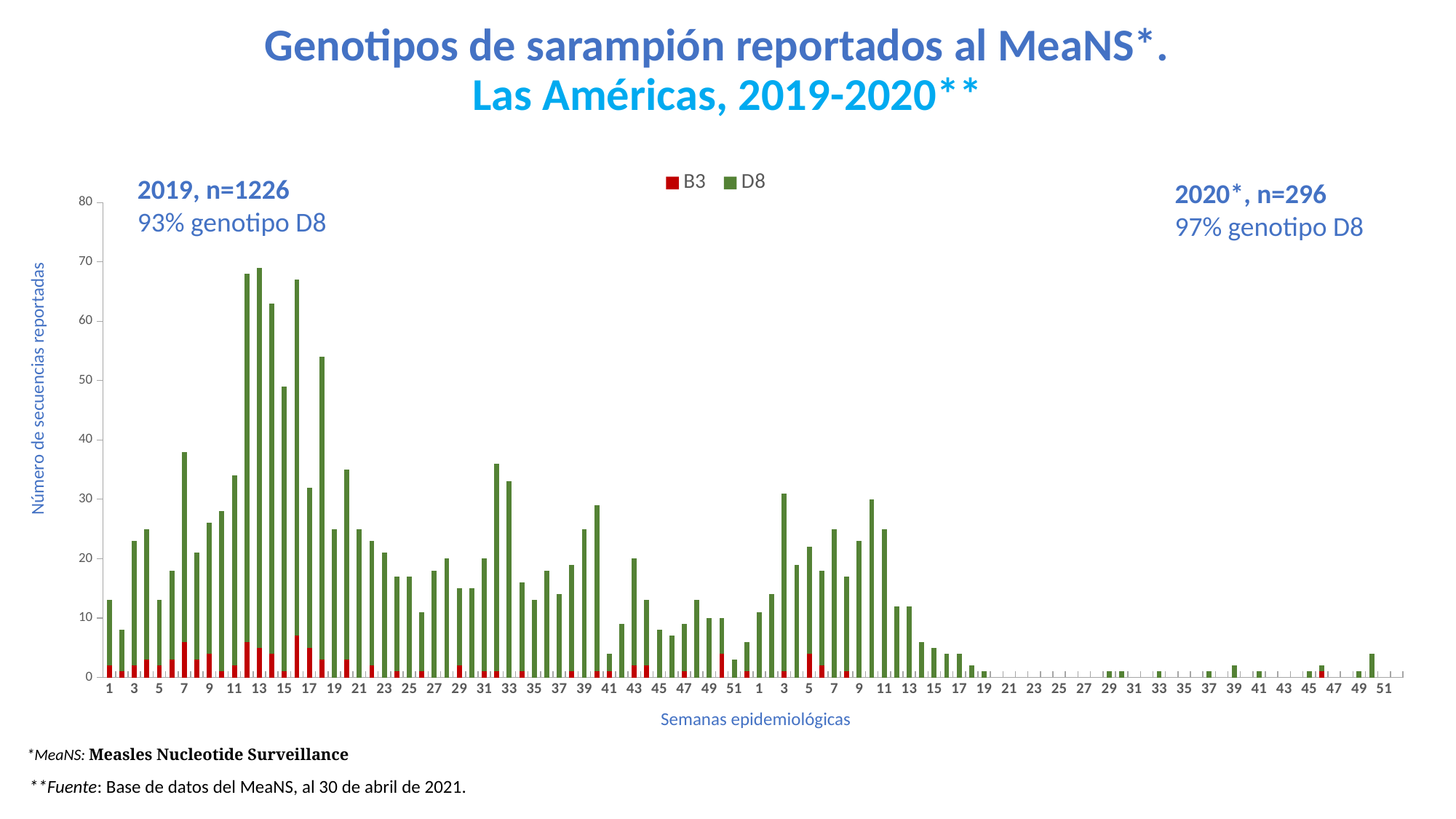
Do the total values rise or fall from epidemiological week 11 to week 19 of 2020? fall Is the total value for epidemiological week 7 of 2019 greater or less than 40? less Which two genotypes are listed in the legend? B3 and D8 Is the total value for epidemiological week 50 of 2020 greater or less than 10? less According to the annotation on the chart, how many sequences were reported in 2019 (n)? 1226 Is the total value for epidemiological week 13 of 2019 greater or less than 60? greater What kind of chart is shown on the slide? Stacked bar chart How many series does the legend list? 2 Do the total values rise or fall from epidemiological week 13 to week 19 of 2019? fall Which has the larger total value: epidemiological week 13 of 2019 or epidemiological week 7 of 2019? Week 13 of 2019